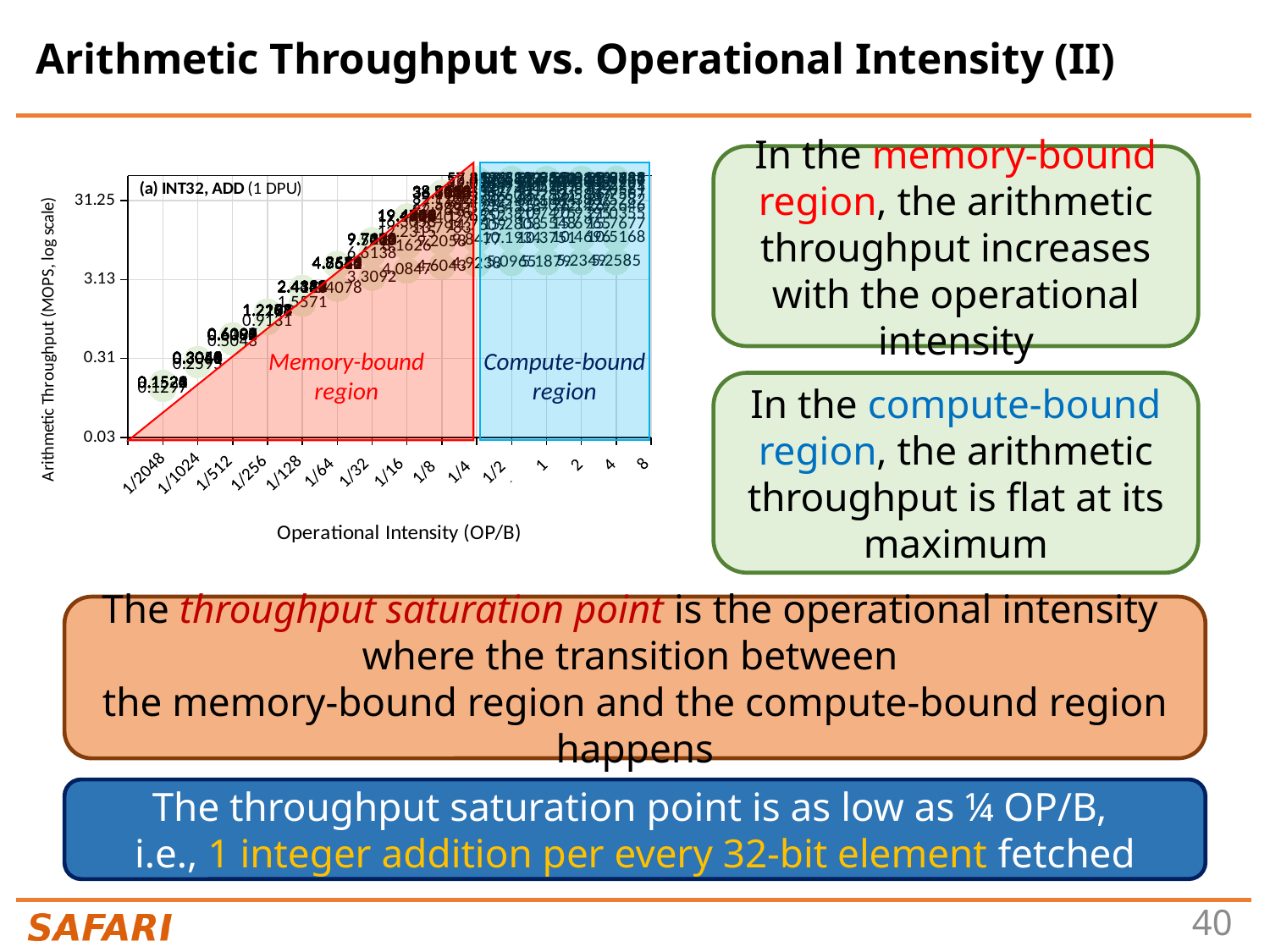
Does the arithmetic throughput rise or fall as operational intensity increases within the memory-bound region? rise What is the label of the y axis of the chart? Arithmetic Throughput (MOPS, log scale) What is the label of the x axis of the chart? Operational Intensity (OP/B) What kind of chart is shown on the slide? scatter chart How many operational intensity values are marked as ticks on the x axis? 15 Is the arithmetic throughput at operational intensity 8 greater or less than 3.13? greater Is the arithmetic throughput at operational intensity 1/1024 greater or less than 3.13? less Which has the higher arithmetic throughput: operational intensity 1/2048 or operational intensity 8? 8 Which region of the chart is shaded blue? Compute-bound region Is the arithmetic throughput at operational intensity 1/2048 greater or less than 0.31? less Which operational intensity has the lowest arithmetic throughput? 1/2048